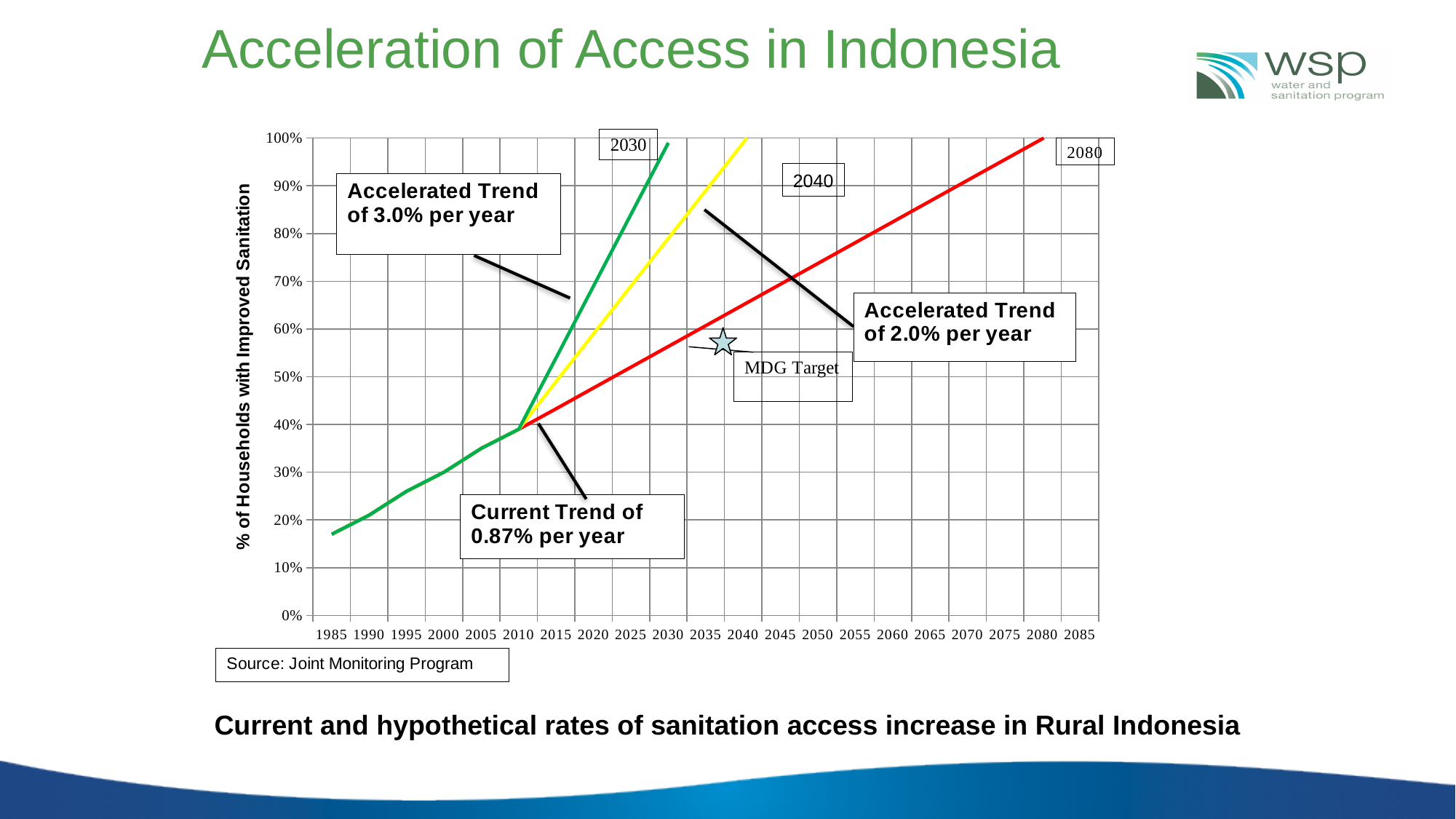
Which trend line reaches 100% first: the 3.0% per year trend or the 0.87% per year trend? 3.0% per year What kind of chart is shown on the slide? line chart Do the plotted lines rise or fall as the years increase along the x axis? rise What source is cited below the chart? Joint Monitoring Program Is the value of the Current Trend of 0.87% per year line in 2040 greater or less than 60%? greater What annual rate is given for the Current Trend? 0.87% per year What annual rate is given for the steepest accelerated trend? 3.0% per year In which year does the Current Trend of 0.87% per year line reach 100%? 2080 In which year does the Accelerated Trend of 3.0% per year line reach 100%? 2030 Is the value for 1985 greater or less than 20%? less What is the label of the vertical axis? % of Households with Improved Sanitation In which year does the Accelerated Trend of 2.0% per year line reach 100%? 2040